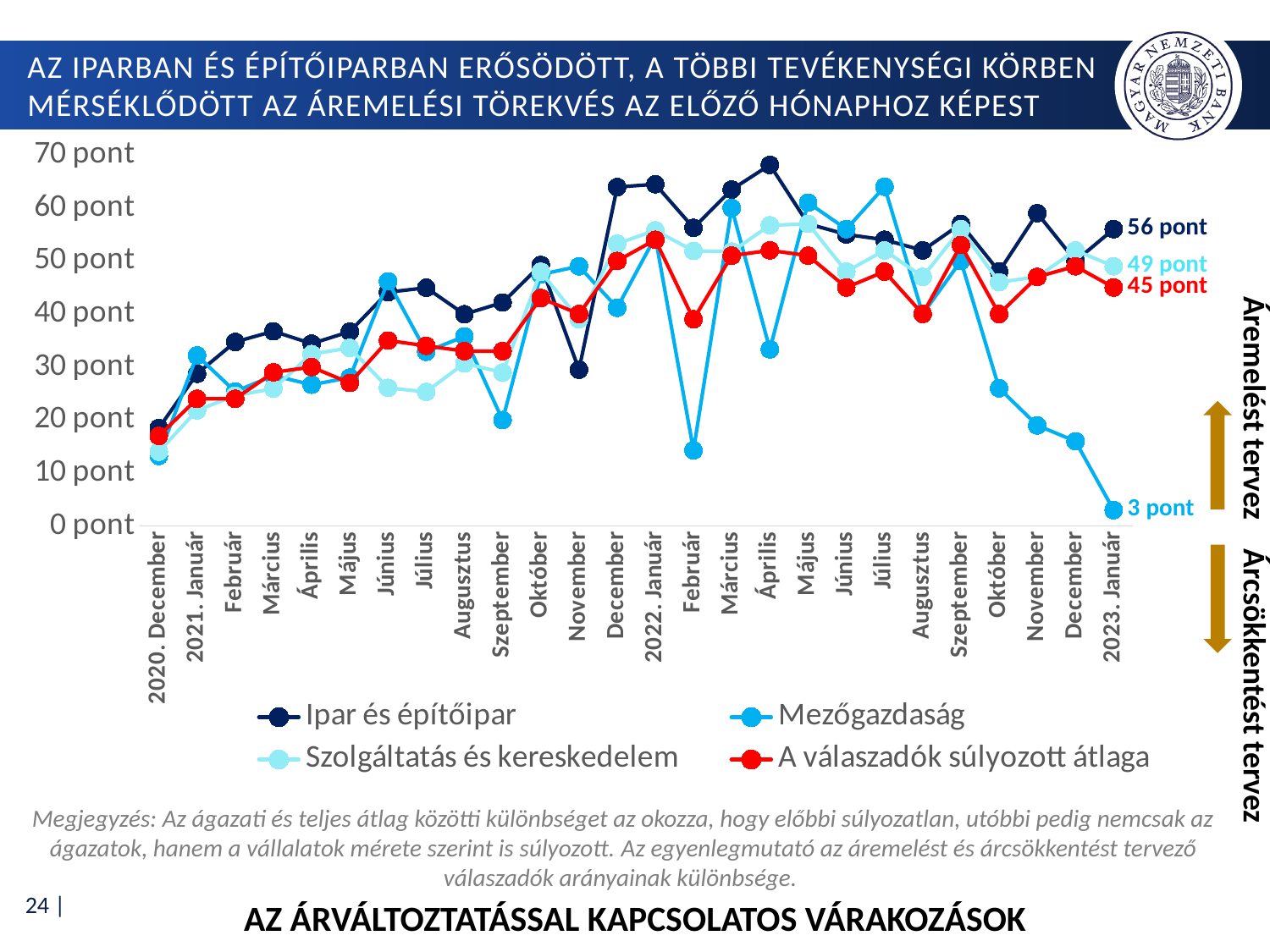
Which series has the lowest value in 2023. Január? Mezőgazdaság What is the value for Szolgáltatás és kereskedelem in 2023. Január? 49 pont What is the difference between the Ipar és építőipar and Mezőgazdaság values in 2023. Január? 53 pont How many series does the legend list? 4 In 2023. Január, which is larger: Szolgáltatás és kereskedelem or A válaszadók súlyozott átlaga? Szolgáltatás és kereskedelem Which series has the highest value in 2023. Január? Ipar és építőipar Is the value for Mezőgazdaság in 2022. Február greater or less than 20 pont? less What is the value for A válaszadók súlyozott átlaga in 2023. Január? 45 pont What is the value for Mezőgazdaság in 2023. Január? 3 pont What kind of chart is shown on the slide? Line chart What is the value for Ipar és építőipar in 2023. Január? 56 pont Is the value for Ipar és építőipar in 2022. Április greater or less than 60 pont? greater